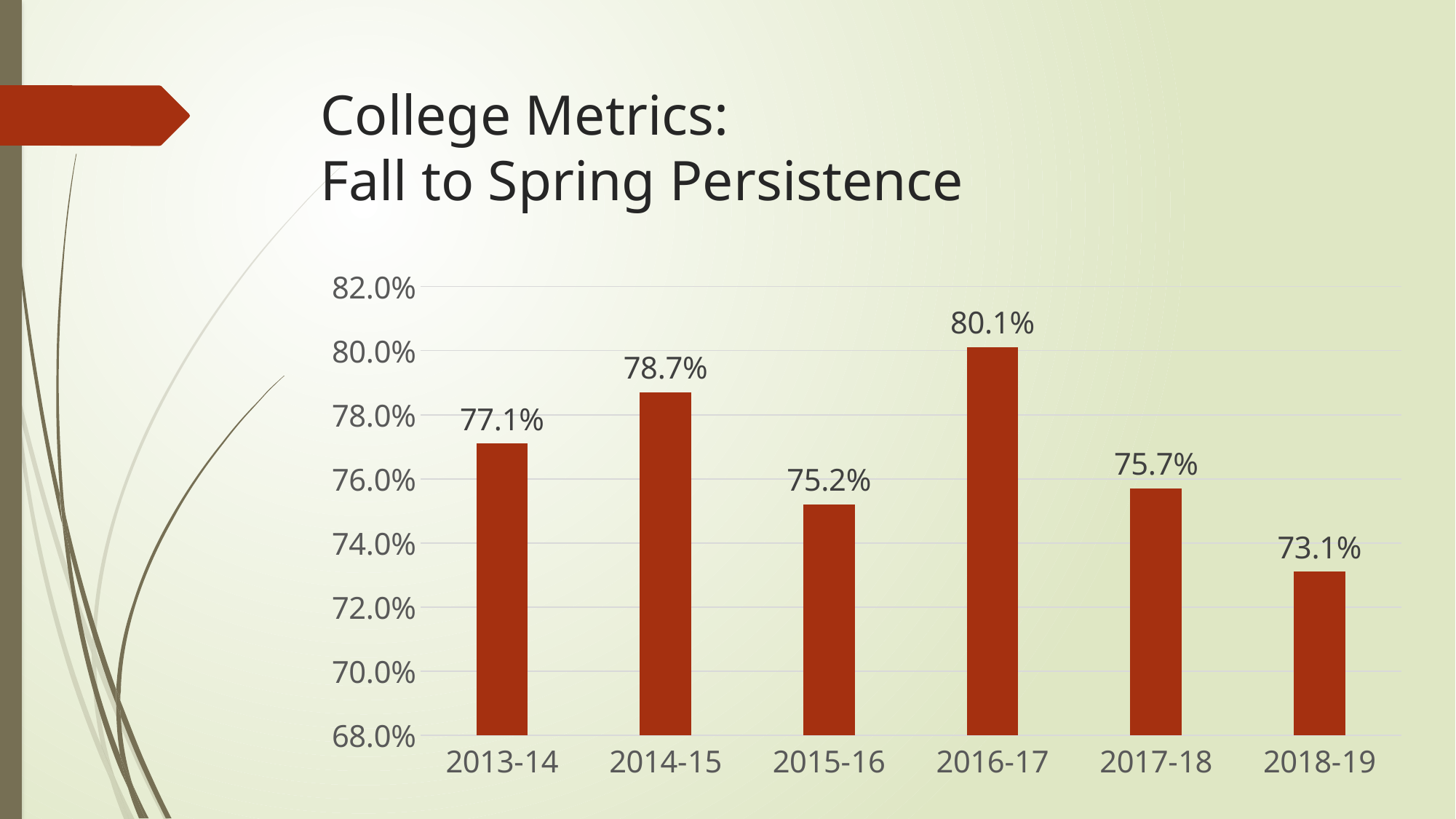
How many academic years are shown in the chart? 6 Which year has the lowest fall to spring persistence rate? 2018-19 Which year has a higher persistence rate, 2015-16 or 2017-18? 2017-18 What is the difference between the persistence rates for 2016-17 and 2018-19? 7.0% What is the difference between the persistence rates for 2014-15 and 2015-16? 3.5% What is the fall to spring persistence rate for 2018-19? 73.1% What is the fall to spring persistence rate for 2013-14? 77.1% Is the persistence rate for 2014-15 greater or less than 78.0%? greater Did the persistence rate rise or fall from 2016-17 to 2018-19? Fall Which year has the highest fall to spring persistence rate? 2016-17 What is the fall to spring persistence rate for 2016-17? 80.1% What kind of chart is shown on the slide? Bar chart